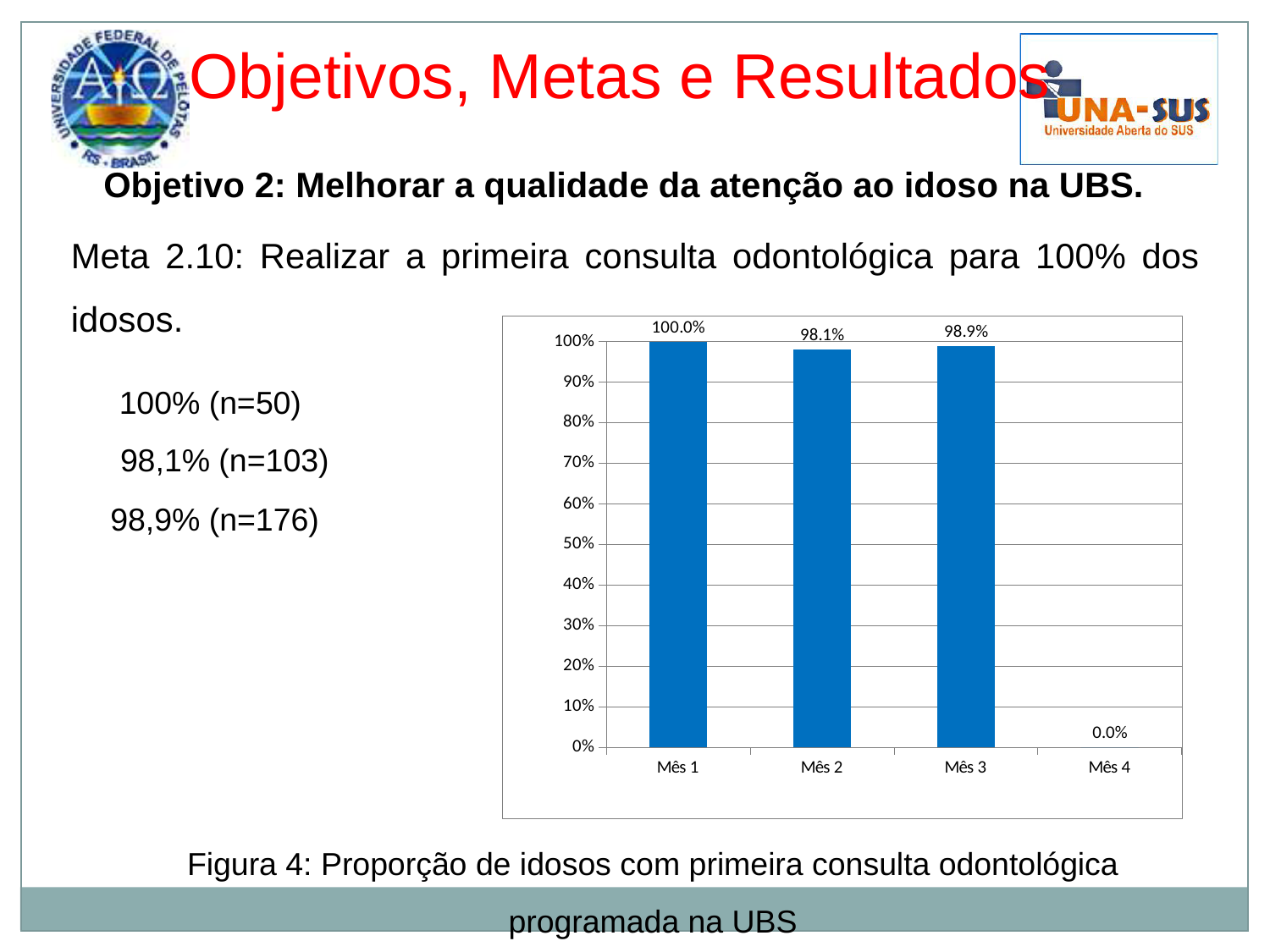
What kind of chart is shown on the slide? Bar chart Which is larger, the value for Mês 2 or the value for Mês 3? Mês 3 What is the value for Mês 2? 98.1% Which month has the lowest value? Mês 4 What is the value for Mês 1? 100.0% What is the caption of the figure shown on the slide? Figura 4: Proporção de idosos com primeira consulta odontológica programada na UBS How many months are shown on the x axis of the chart? 4 What is the value for Mês 4? 0.0% What is the difference between the values for Mês 3 and Mês 2? 0.8% What is the difference between the values for Mês 1 and Mês 2? 1.9% Which month has the highest value? Mês 1 What is the value for Mês 3? 98.9%